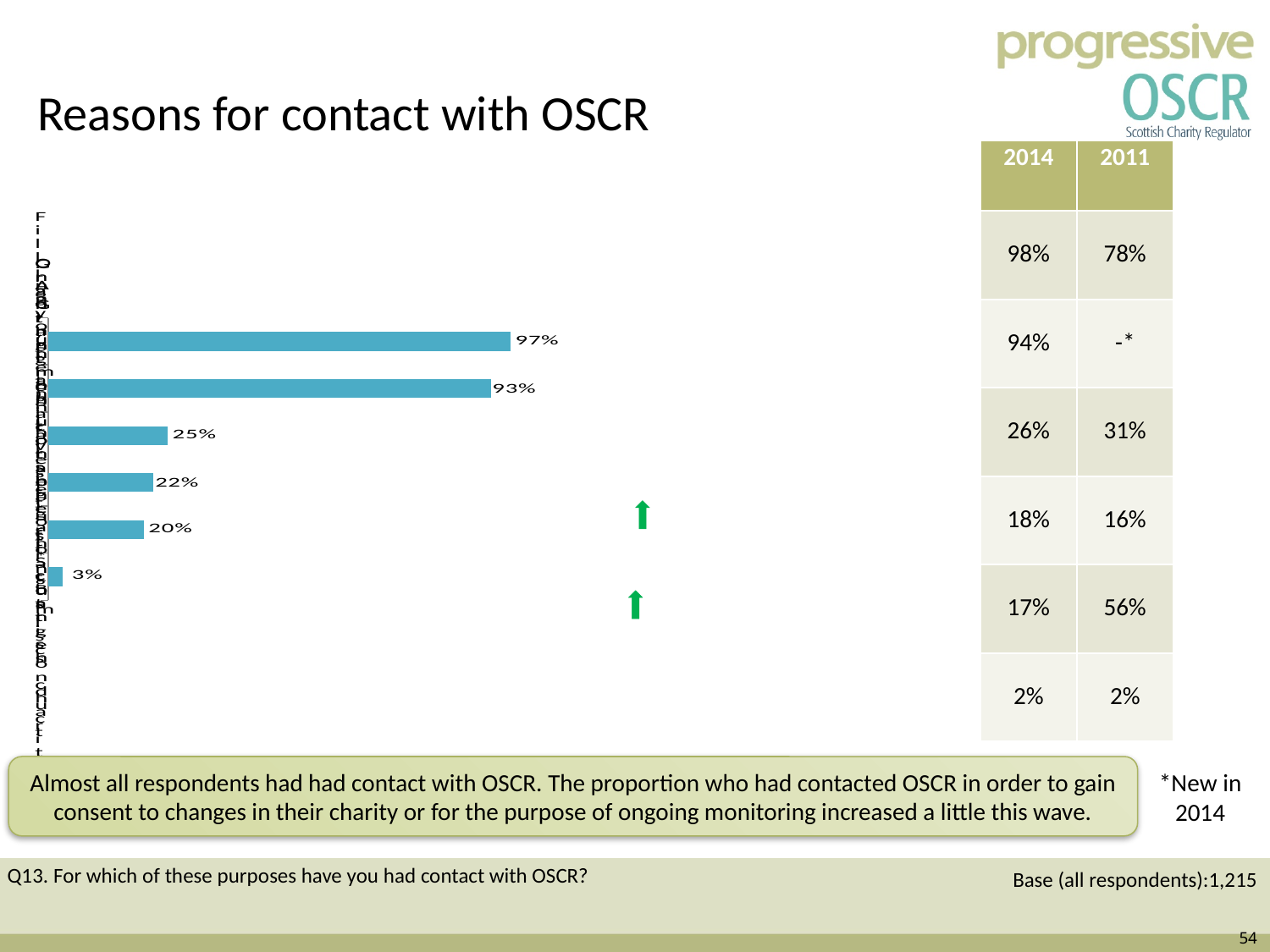
What is the value shown on the second bar from the top of the bar chart? 93% What is the value shown on the fourth bar from the top of the bar chart? 22% What kind of chart is shown on the slide? bar chart Do the bar values in the bar chart increase or decrease going from the top bar to the bottom bar? decrease What is the value shown on the third bar from the top of the bar chart? 25% What is the highest value labelled in the bar chart? 97% What is the difference between the top bar (97%) and the second bar (93%) in the bar chart? 4 percentage points How many bars does the bar chart contain? 6 What is the lowest value labelled in the bar chart? 3% What is the value shown on the bottom bar of the bar chart? 3% What is the value shown on the top bar of the bar chart? 97% What is the value shown on the fifth bar from the top of the bar chart? 20%